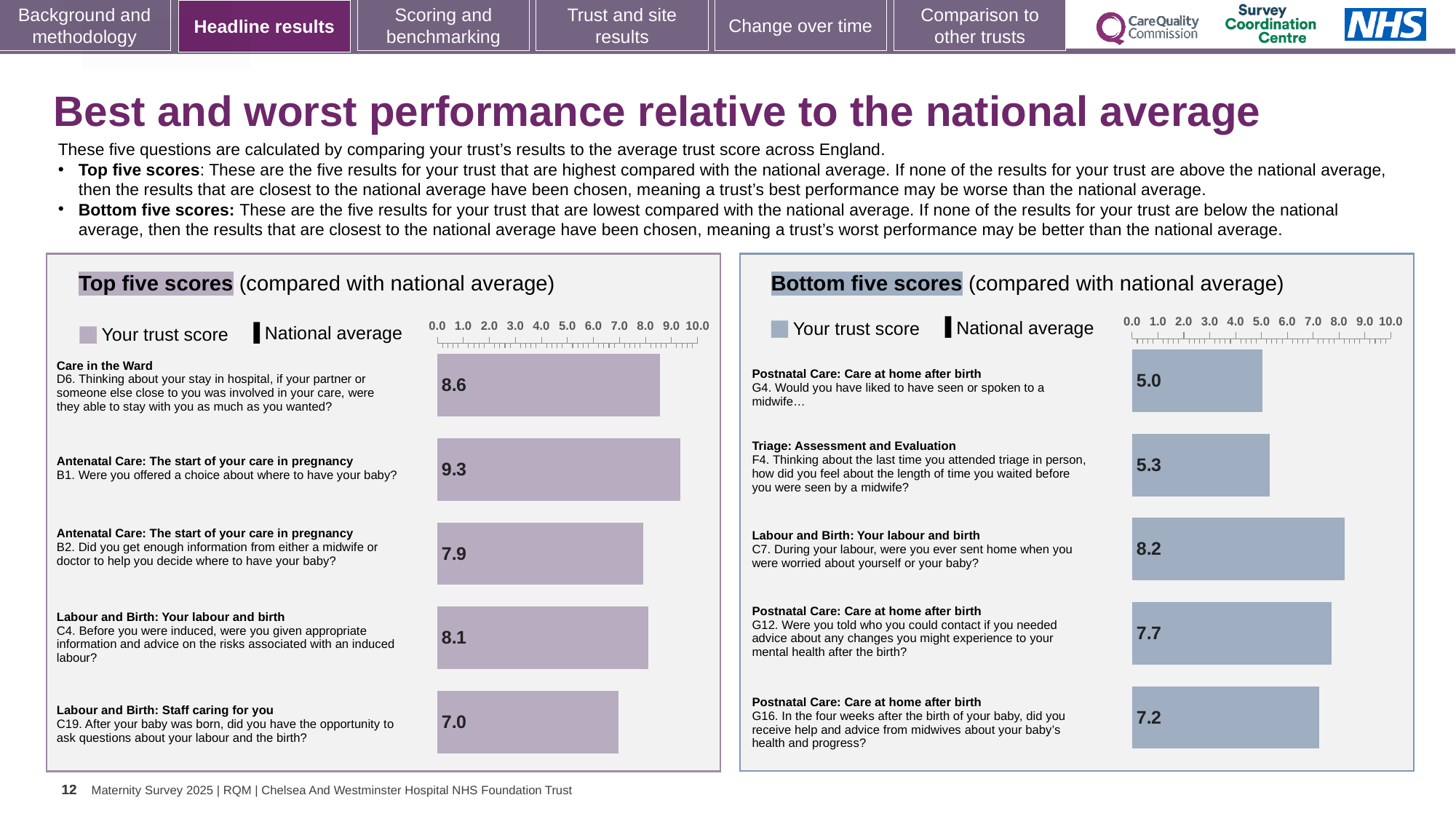
In the Top five scores chart, what is the difference between the trust scores for B1 and C19? 2.3 What type of chart is the Top five scores chart? Bar chart How many bars are plotted in the Bottom five scores chart? 5 In the Top five scores chart, which question has the highest trust score? B1. Were you offered a choice about where to have your baby? (9.3) In the Top five scores chart, which has the larger trust score: D6 or C4? D6 (8.6) In the Bottom five scores chart, what is the trust score for G4 (Would you have liked to have seen or spoken to a midwife…)? 5.0 In the Bottom five scores chart, what is the difference between the trust scores for C7 and G4? 3.2 In the Bottom five scores chart, which question has the lowest trust score? G4. Would you have liked to have seen or spoken to a midwife… (5.0) In the Top five scores chart, what is the trust score for B1 (Were you offered a choice about where to have your baby?)? 9.3 In the Top five scores chart, which question has the lowest trust score? C19. After your baby was born, did you have the opportunity to ask questions about your labour and the birth? (7.0) In the Bottom five scores chart, what is the trust score for G12 (Were you told who you could contact if you needed advice about changes to your mental health after the birth?)? 7.7 In the Bottom five scores chart, which question has the highest trust score? C7. During your labour, were you ever sent home when you were worried about yourself or your baby? (8.2)